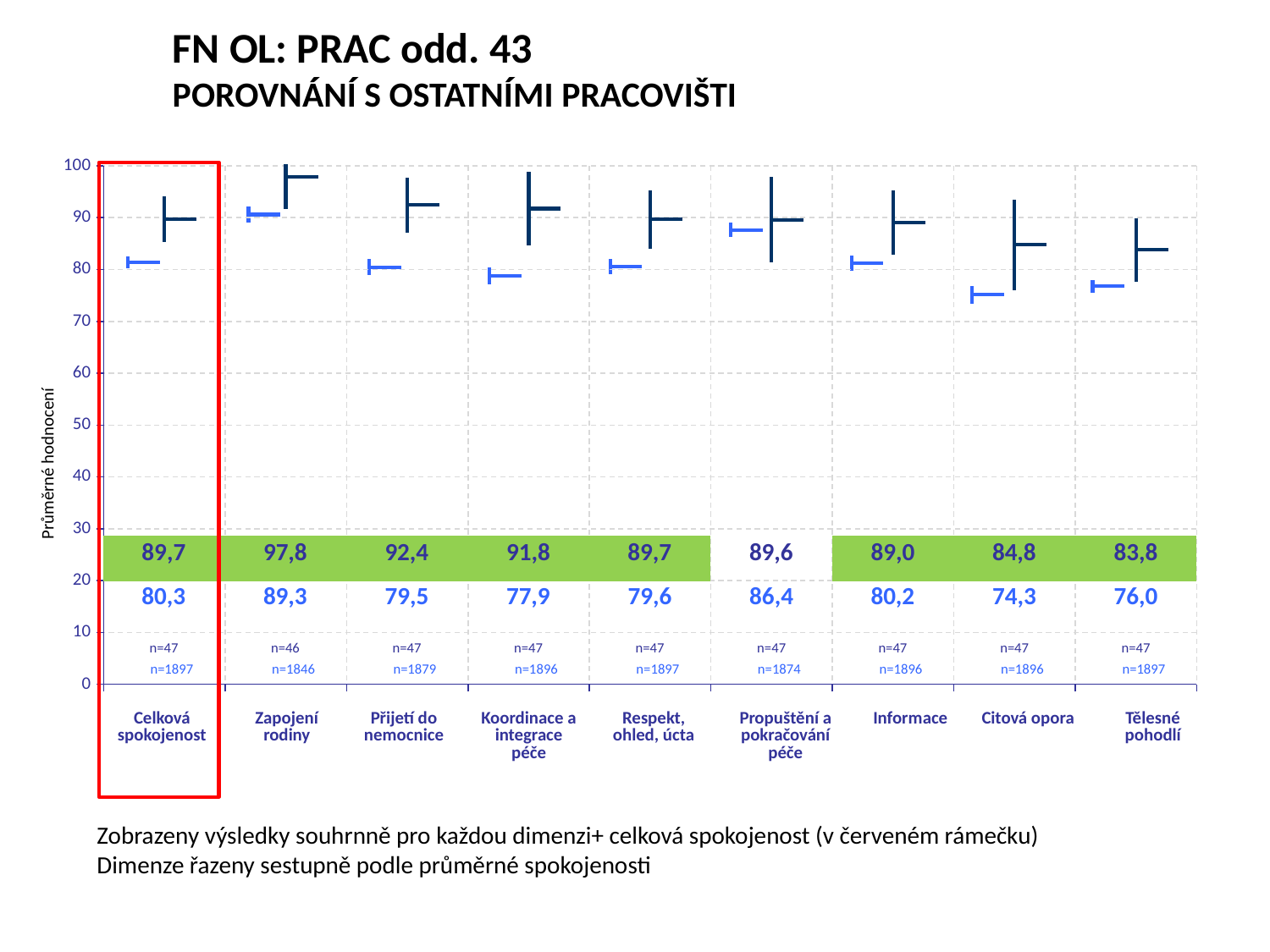
What is the sample size (n) for the department in the Zapojení rodiny category? n=46 What is the light blue (other workplaces) value for Citová opora? 74,3 Which category has the highest dark navy value? Zapojení rodiny What is the dark navy (department) value for Zapojení rodiny? 97,8 Which category has the lowest light blue value? Citová opora What is the light blue value for Propuštění a pokračování péče? 86,4 Which is larger for Tělesné pohodlí: the dark navy value or the light blue value? the dark navy value (83,8) How many categories are shown on the x axis? 9 What is the dark navy value for Celková spokojenost? 89,7 What is the difference between the dark navy and light blue values for Koordinace a integrace péče? 13,9 Is the light blue value for Přijetí do nemocnice greater or less than 80? less